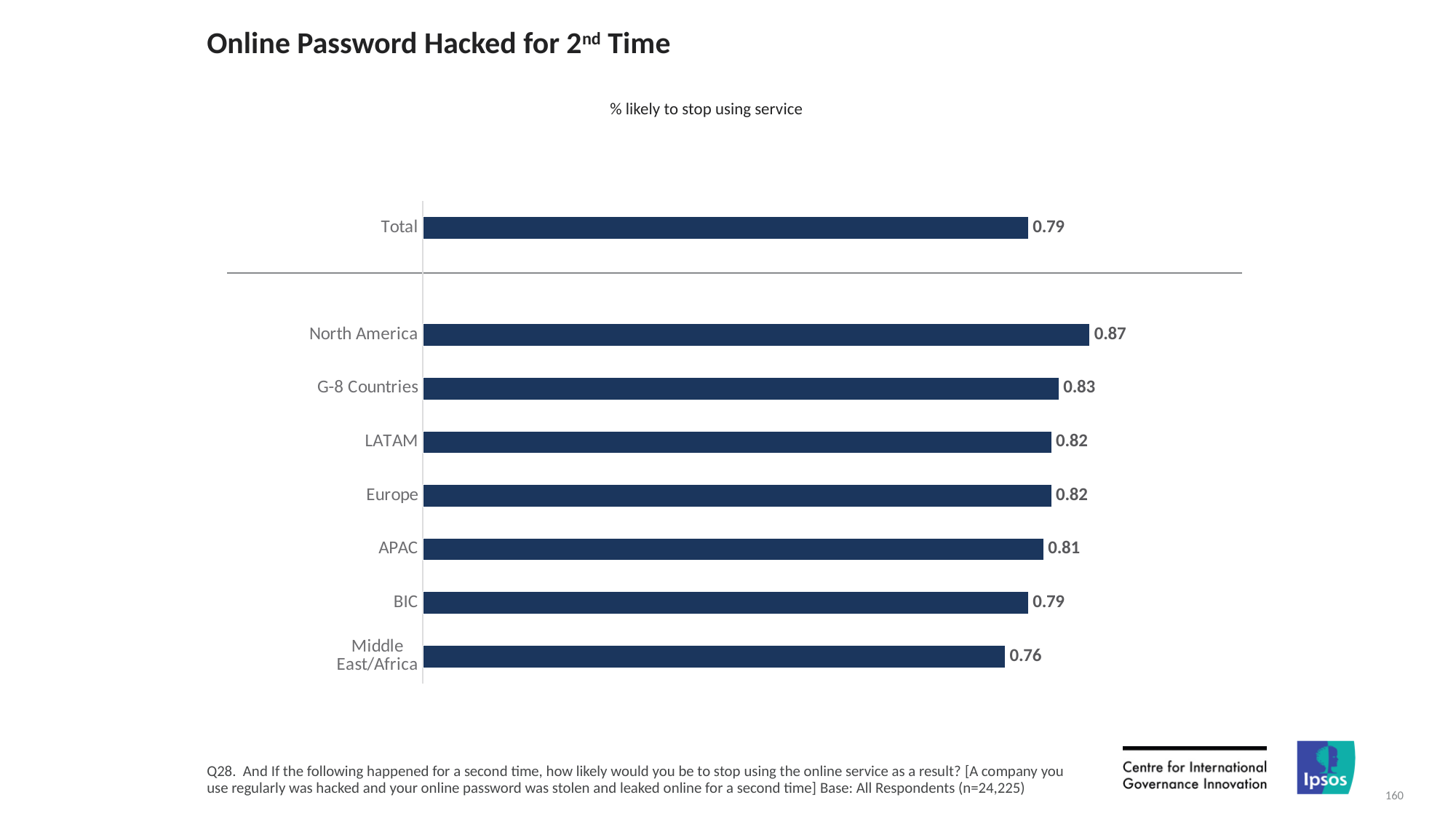
Which region has the highest value? North America How many bars are plotted on the chart, including Total? 8 What is the value for the Total bar? 0.79 What is the value for Middle East/Africa? 0.76 What is the difference between the values for G-8 Countries and BIC? 0.04 What kind of chart is shown on the slide? Bar chart What is the value for APAC? 0.81 What is the subtitle shown above the chart? % likely to stop using service What is the difference between the values for North America and Middle East/Africa? 0.11 What is the value for North America? 0.87 Which is larger, the value for G-8 Countries or the value for APAC? G-8 Countries Which region has the lowest value? Middle East/Africa